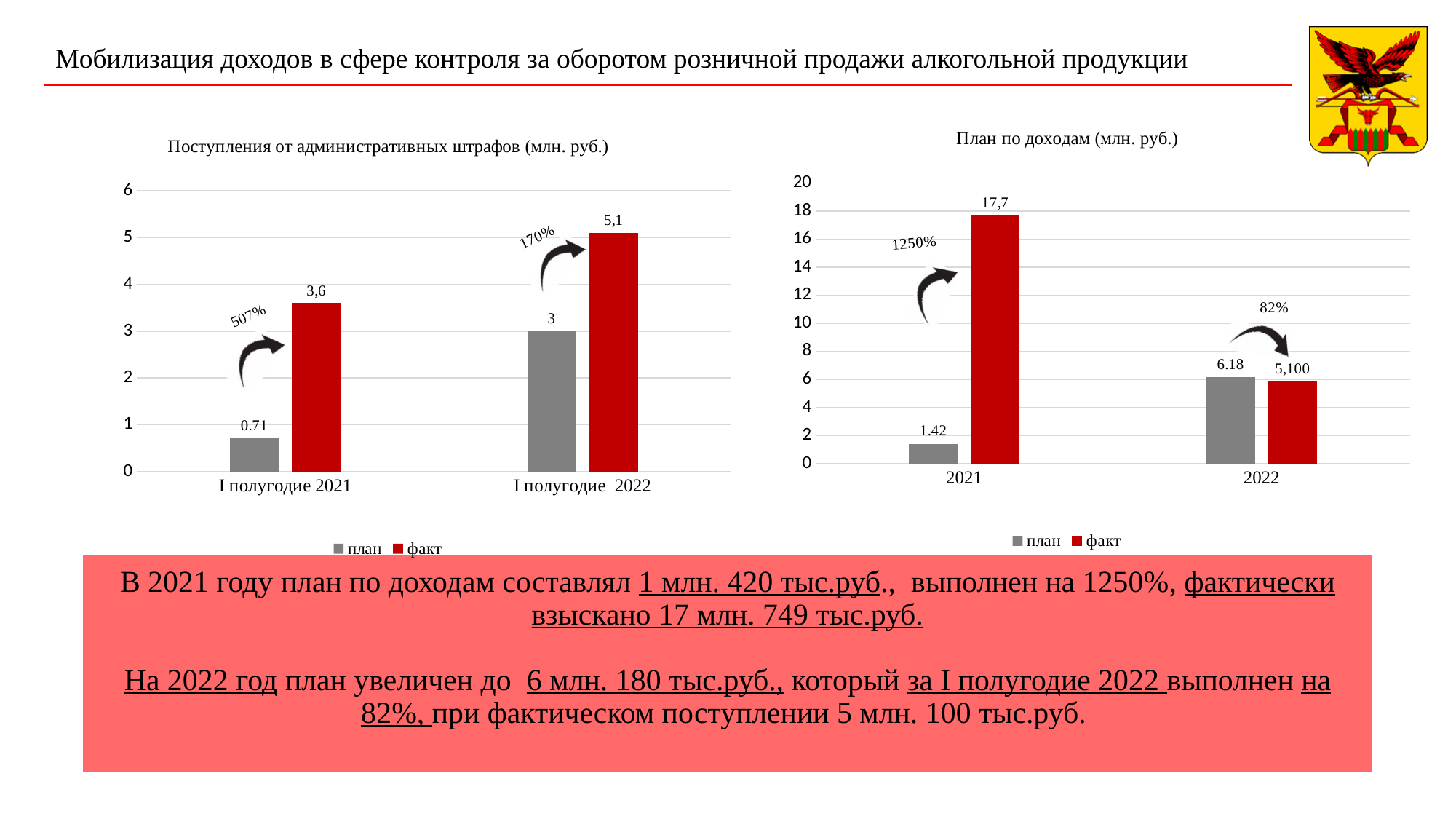
In the chart 'План по доходам (млн. руб.)', which category has the highest 'факт' value? 2021 In the chart 'Поступления от административных штрафов (млн. руб.)', what is the value of 'факт' for 'I полугодие 2022'? 5,1 In the chart 'План по доходам (млн. руб.)', for 2022, which is larger: 'план' or 'факт'? план In the chart 'Поступления от административных штрафов (млн. руб.)', what is the difference between 'факт' and 'план' for 'I полугодие 2022'? 2,1 In the chart 'Поступления от административных штрафов (млн. руб.)', which series has the lowest value for 'I полугодие 2021'? план How many series does the legend of the chart 'План по доходам (млн. руб.)' list? 2 In the chart 'План по доходам (млн. руб.)', what is the value of 'факт' for 2021? 17,7 In the chart 'Поступления от административных штрафов (млн. руб.)', does the 'факт' value rise or fall from 'I полугодие 2021' to 'I полугодие 2022'? rise In the chart 'План по доходам (млн. руб.)', what is the value of 'план' for 2022? 6.18 In the chart 'План по доходам (млн. руб.)', is the 'факт' value for 2021 greater or less than 16? greater What type of chart is 'Поступления от административных штрафов (млн. руб.)'? bar chart In the chart 'Поступления от административных штрафов (млн. руб.)', what is the value of 'план' for 'I полугодие 2021'? 0.71